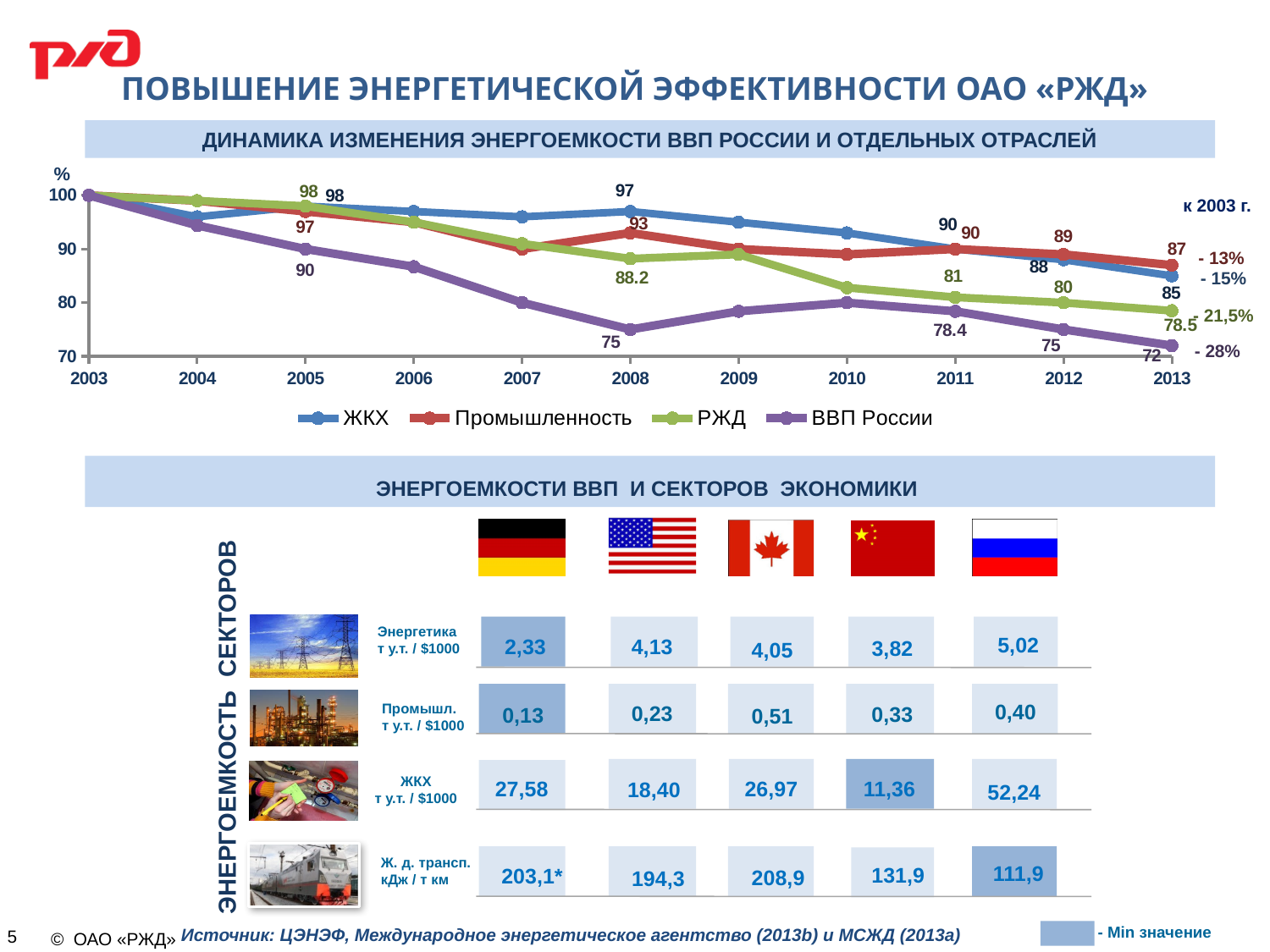
In the line chart, which series has the highest value in 2013? Промышленность What kind of chart is shown under the title «ДИНАМИКА ИЗМЕНЕНИЯ ЭНЕРГОЕМКОСТИ ВВП РОССИИ И ОТДЕЛЬНЫХ ОТРАСЛЕЙ»? line chart In the line chart, what is the value of the Промышленность series in 2012? 89 In the line chart, is the value of the РЖД series in 2010 greater or less than 90? less How many series does the legend of the line chart list? 4 In the line chart, what is the value of the ВВП России series in 2008? 75 In the line chart, which is larger in 2011: the РЖД value or the ВВП России value? РЖД In the line chart, does the ВВП России series rise or fall from 2003 to 2013? fall In the line chart, which series has the lowest value in 2013? ВВП России In the line chart, what is the value of the РЖД series in 2013? 78.5 In the line chart, what is the difference between the ЖКХ value and the ВВП России value in 2013? 13 In the line chart, what is the value of the ЖКХ series in 2008? 97